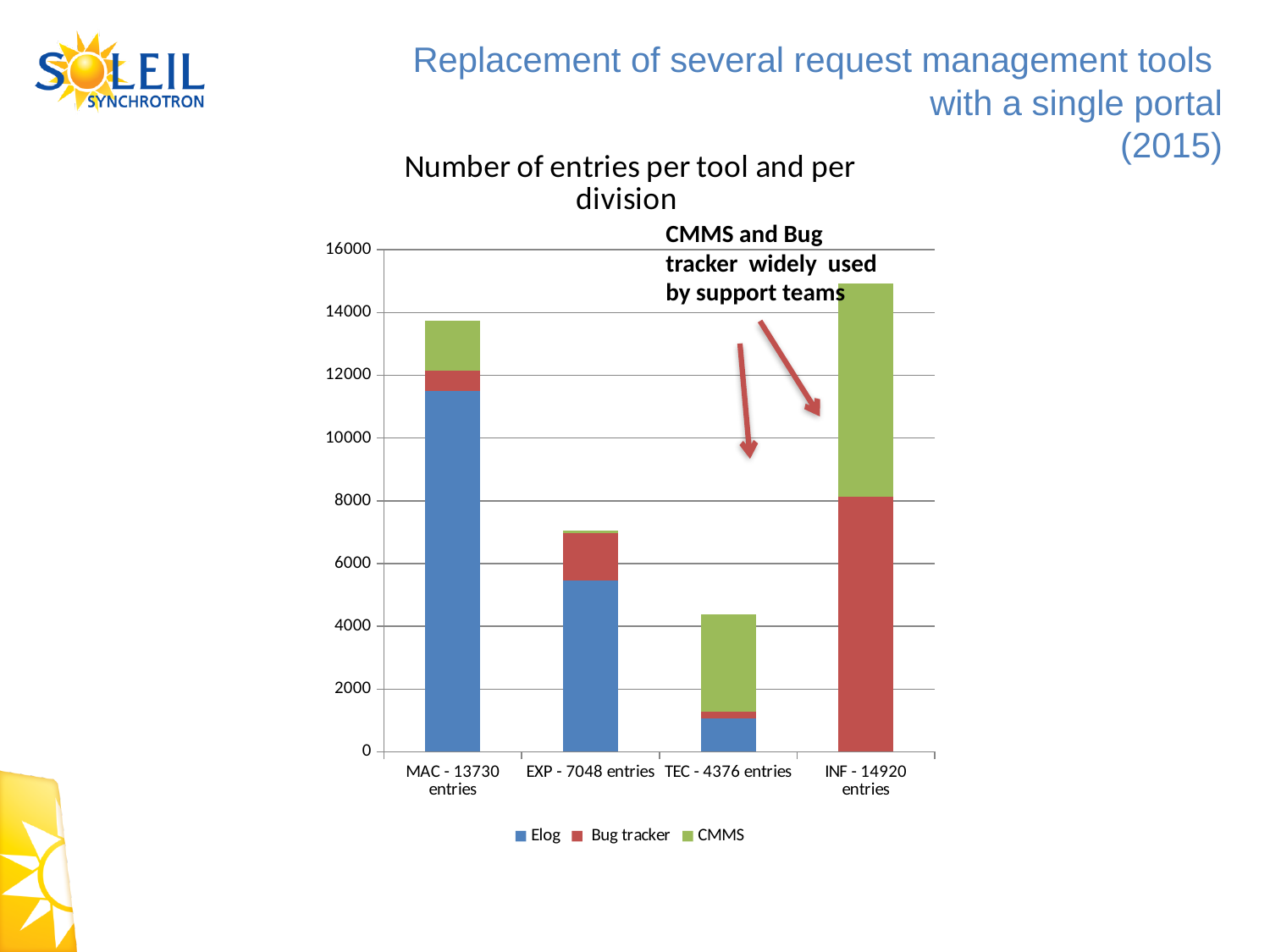
Which division has more total entries, EXP or TEC? EXP What kind of chart is shown on the slide? Stacked bar chart How many divisions (categories) are shown on the x axis? 4 Which series is shown in green in the legend? CMMS What is the title of the chart? Number of entries per tool and per division Which division has the lowest total number of entries? TEC Is the Elog value for the MAC division greater or less than 10000? greater What is the total number of entries for the TEC division? 4376 Which division has the highest total number of entries? INF How many series does the legend list? 3 What is the difference between the total entries of INF and MAC? 1190 What is the total number of entries for the MAC division? 13730